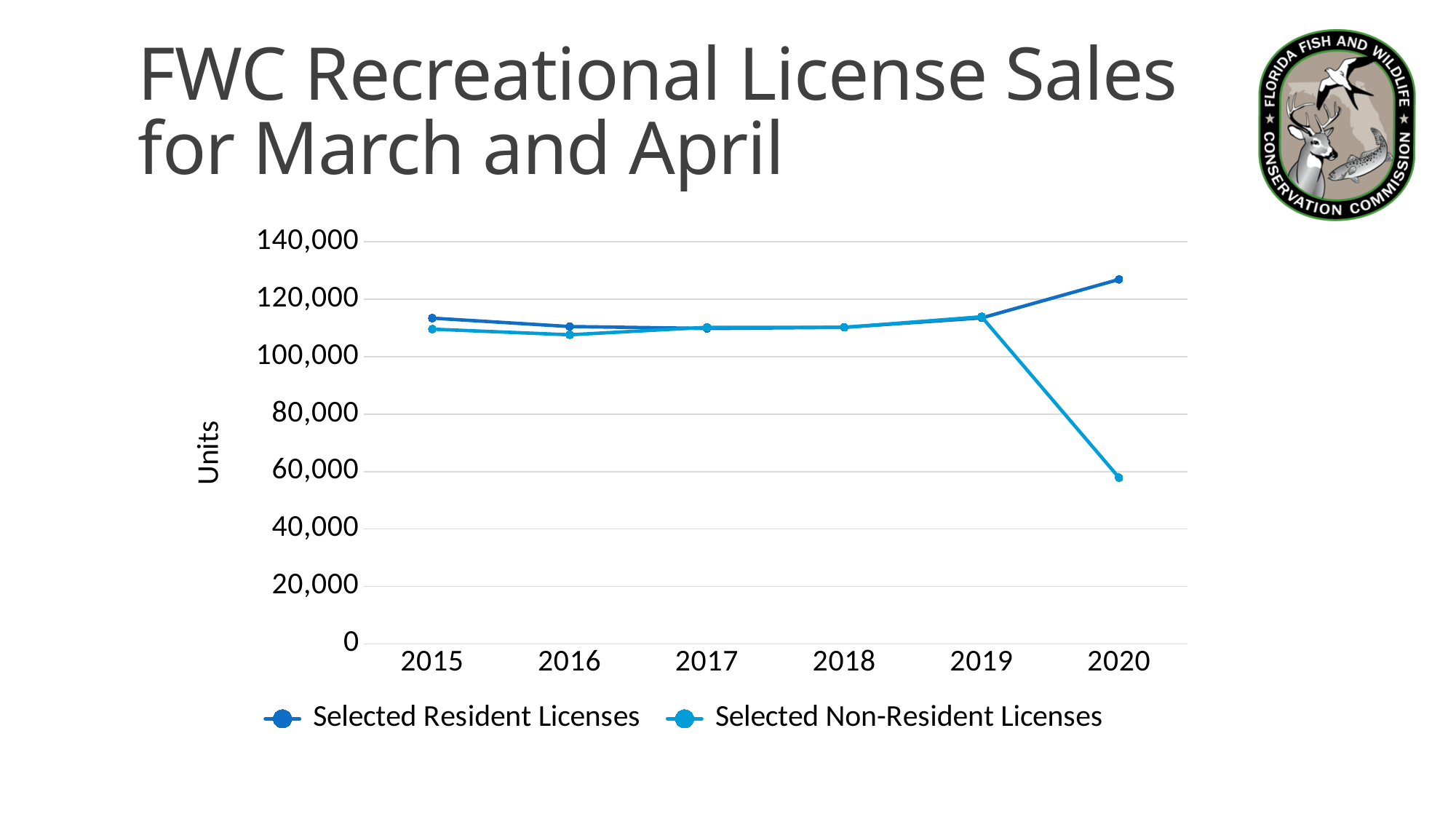
In 2020, which series has the larger value, Selected Resident Licenses or Selected Non-Resident Licenses? Selected Resident Licenses Is the value for Selected Resident Licenses in 2020 greater or less than 120,000? greater How many years are plotted along the x axis? 6 Does the value for Selected Resident Licenses rise or fall from 2019 to 2020? rise In which year is the value for Selected Non-Resident Licenses lowest? 2020 What is the label on the y axis of the chart? Units What kind of chart is shown on the slide? line chart In which year is the value for Selected Resident Licenses highest? 2020 Is the value for Selected Non-Resident Licenses in 2020 greater or less than 80,000? less Is the value for Selected Non-Resident Licenses in 2015 greater or less than 100,000? greater How many series does the legend list? 2 Does the value for Selected Non-Resident Licenses rise or fall from 2019 to 2020? fall